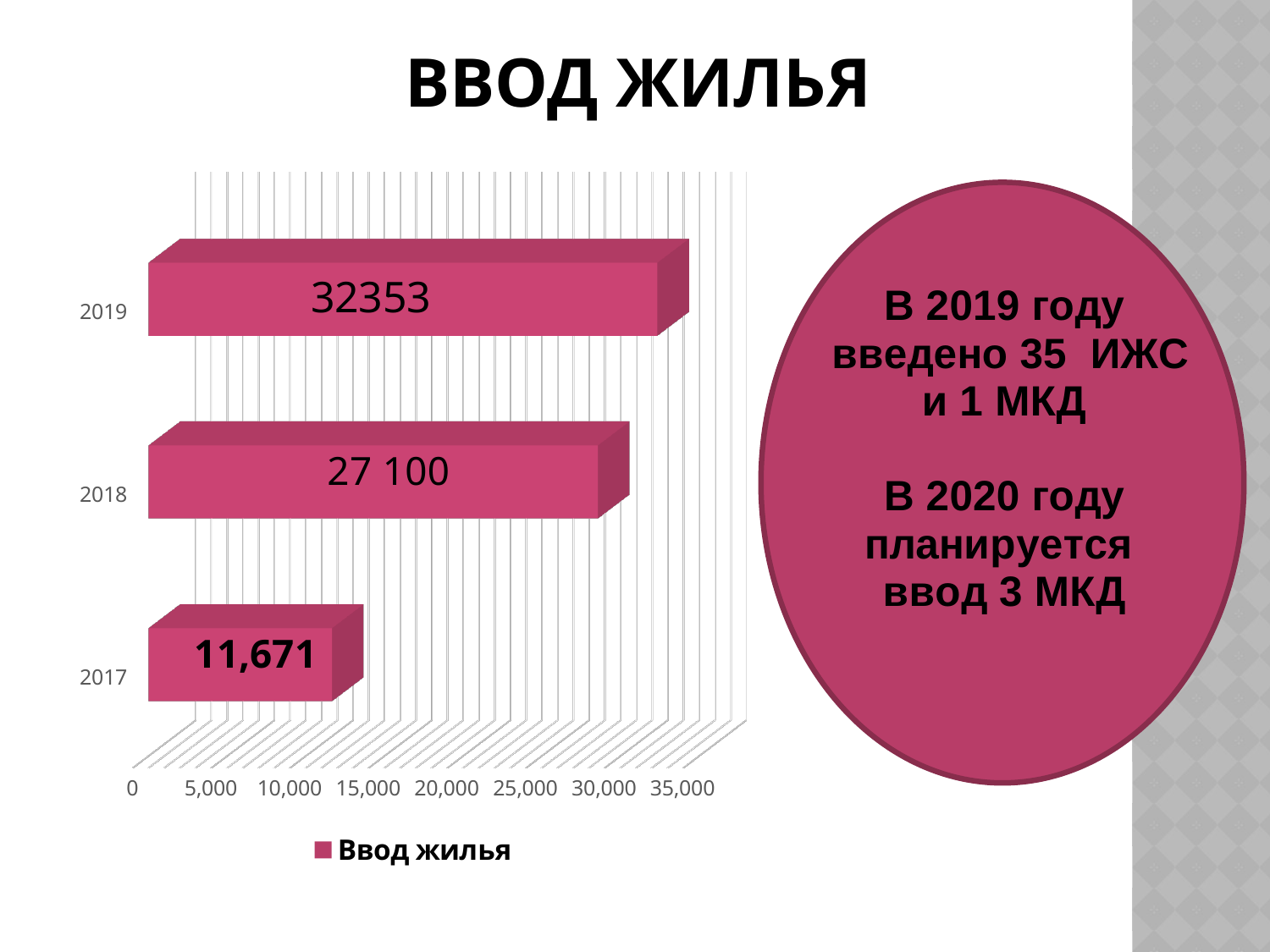
What is the value for 2019? 32353 What is the value for 2018? 27 100 What is the difference between the values for 2019 and 2018? 5253 Which year has the highest value? 2019 What kind of chart is shown? bar chart How many series does the legend list? 1 Is the value for 2017 greater or less than 15,000? less How many years are shown on the chart? 3 Which is larger, the value for 2018 or the value for 2017? 2018 Which year has the lowest value? 2017 What is the title of the chart? ВВОД ЖИЛЬЯ What is the value for 2017? 11,671